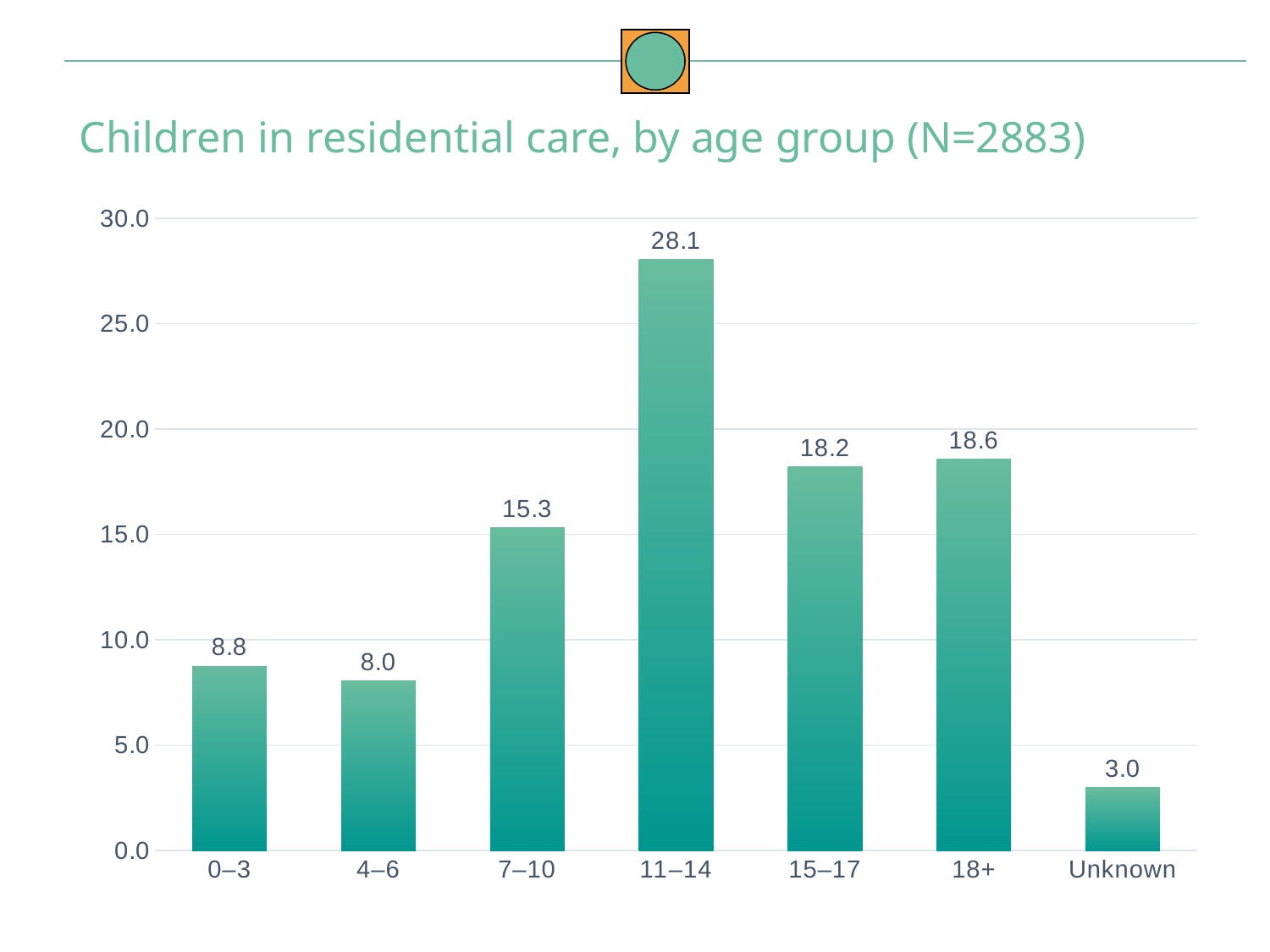
How many categories are shown on the x axis? 7 Is the value for 15–17 greater or less than 20.0? less Which is larger, the value for 0–3 or the value for 4–6? 0–3 What is the title of the chart? Children in residential care, by age group (N=2883) What is the value for the 11–14 age group? 28.1 What kind of chart is shown on the slide? bar chart What is the value for the Unknown category? 3.0 What is the difference between the values for 18+ and 15–17? 0.4 What is the difference between the values for 11–14 and 7–10? 12.8 Which age group has the highest value? 11–14 What is the value for the 0–3 age group? 8.8 Which category has the lowest value? Unknown